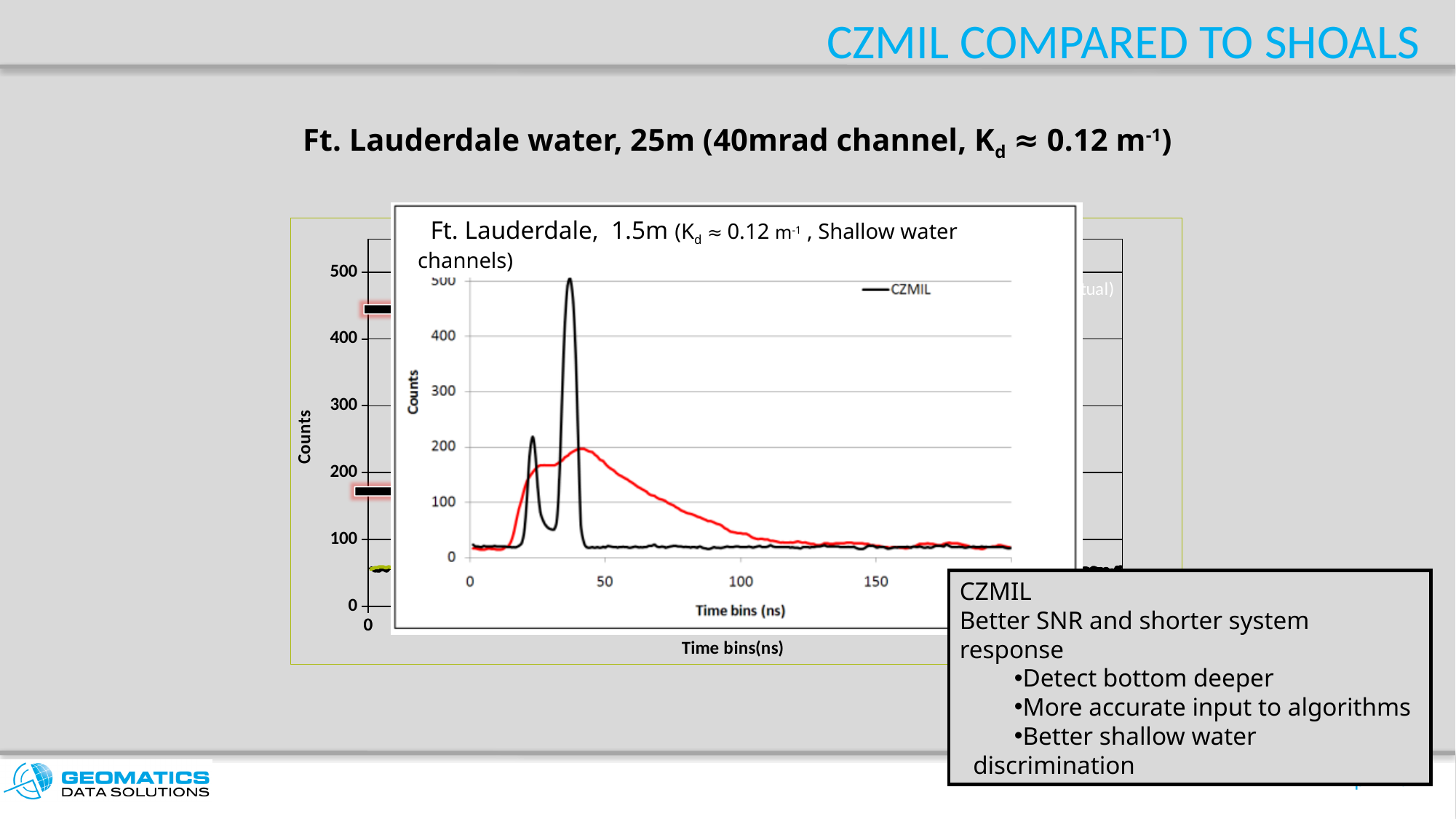
In the foreground chart titled 'Ft. Lauderdale, 1.5m', what kind of chart is shown? line chart In the foreground chart titled 'Ft. Lauderdale, 1.5m', is the value of the black CZMIL line at 100 ns greater or less than 100 counts? less In the foreground chart titled 'Ft. Lauderdale, 1.5m', how many lines are plotted? 2 In the foreground chart titled 'Ft. Lauderdale, 1.5m', is the peak of the red line greater or less than 100 counts? greater In the foreground chart titled 'Ft. Lauderdale, 1.5m', is the smaller first peak of the black CZMIL line (near 25 ns) greater or less than 300 counts? less In the foreground chart titled 'Ft. Lauderdale, 1.5m', what series name is shown in the legend? CZMIL In the foreground chart titled 'Ft. Lauderdale, 1.5m', what is the label of the x axis? Time bins (ns) In the foreground chart titled 'Ft. Lauderdale, 1.5m', does the red line rise or fall between 50 ns and 100 ns? fall In the foreground chart titled 'Ft. Lauderdale, 1.5m', which line reaches a higher peak, the black CZMIL line or the red line? the black CZMIL line